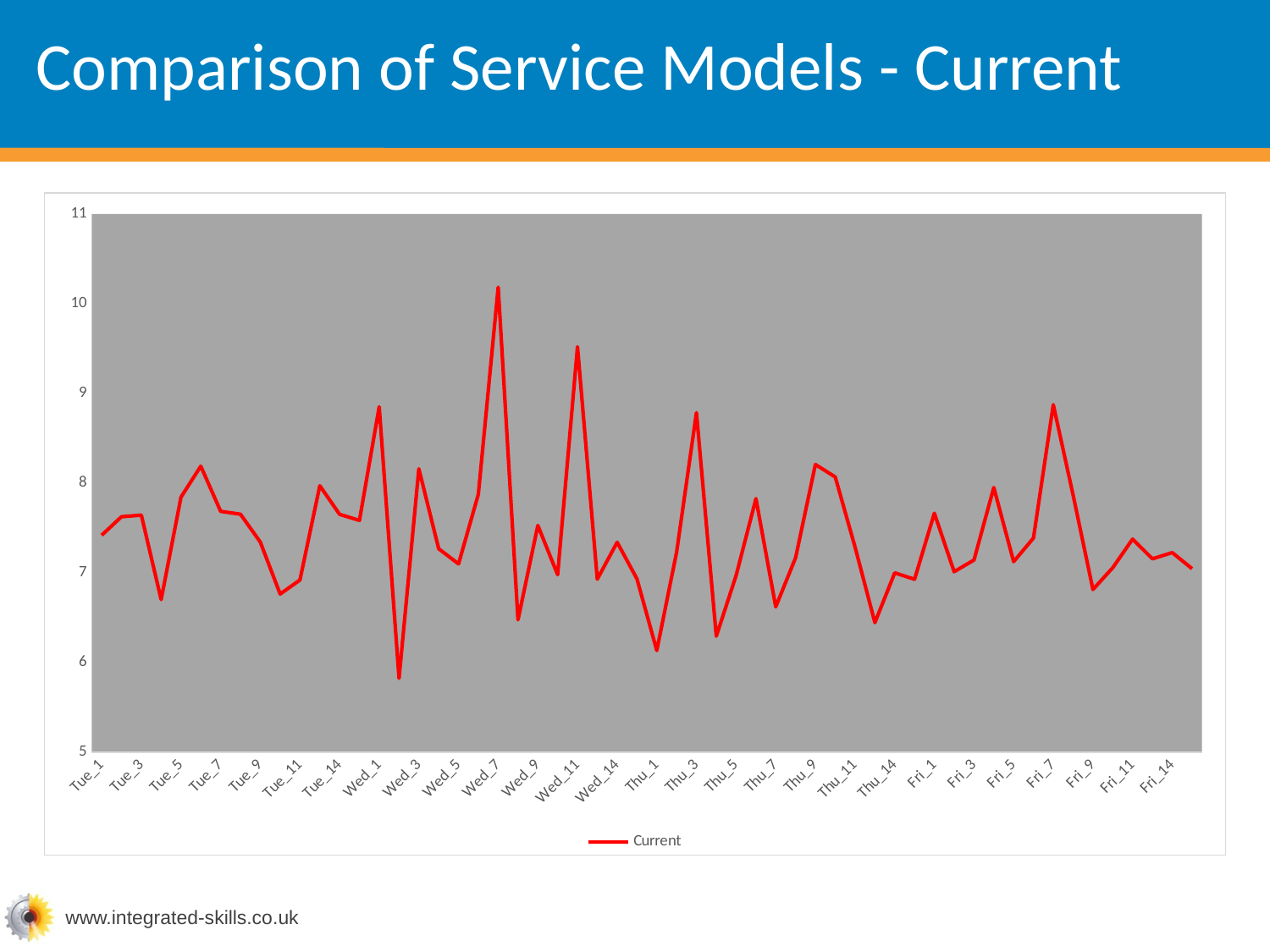
What is the title of the slide containing the chart? Comparison of Service Models - Current How many series does the legend list? 1 What is the name of the series shown in the legend? Current What kind of chart is shown on the slide? Line chart Is the value for Thu_11 greater or less than 7? greater Is the value for Wed_7 greater or less than 9? greater At which labelled point does the Current line reach its highest value? Wed_7 Is the value for Wed_11 greater or less than 9? greater Which has the larger value, Wed_7 or Wed_11? Wed_7 Does the Current line rise or fall between Wed_3 and Wed_7? rise